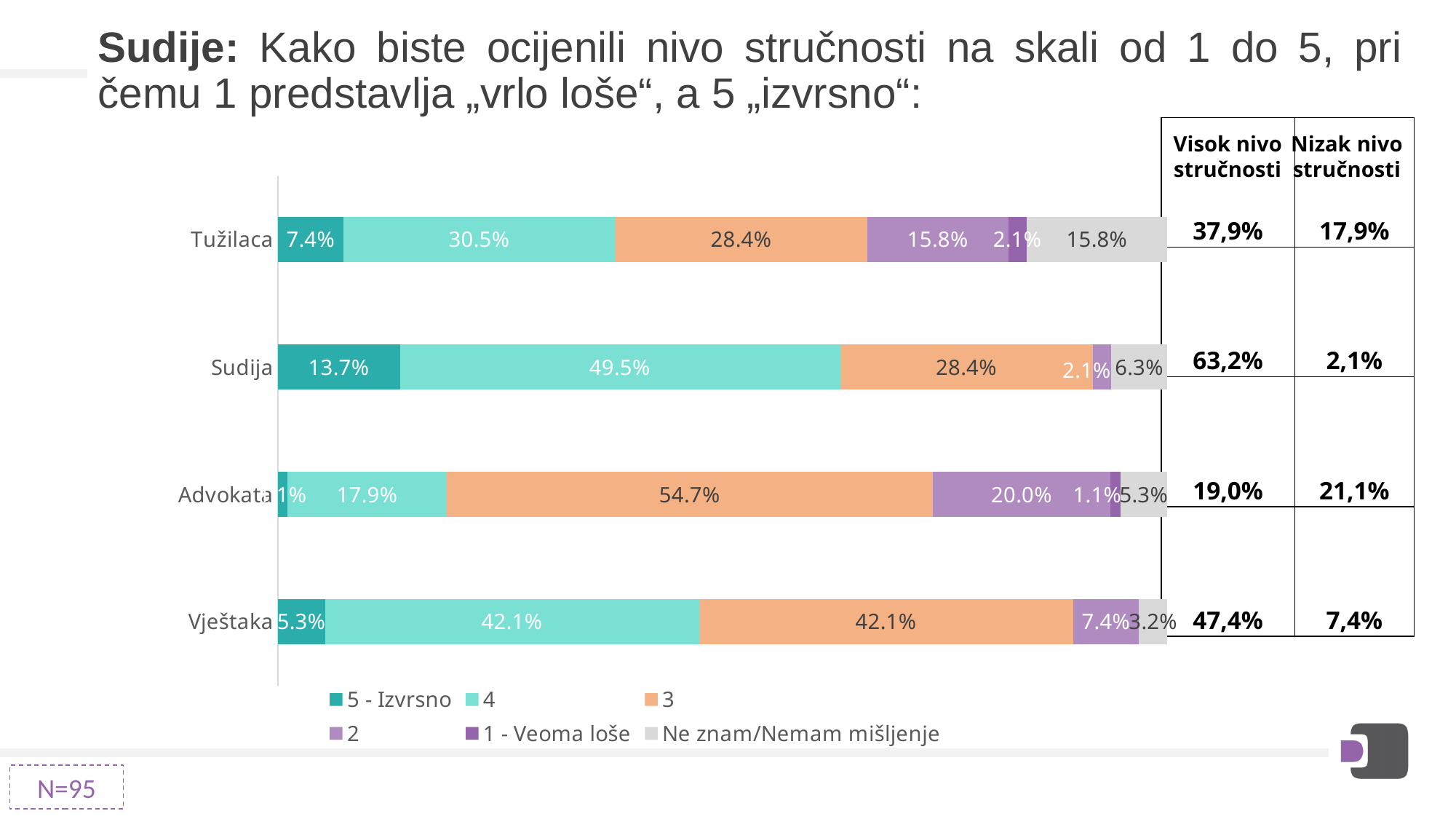
What is the value of the '5 - Izvrsno' series for Tužilaca? 7.4% How many series does the legend list? 6 Which category has the highest value for the '5 - Izvrsno' series? Sudija What is the value of the 'Ne znam/Nemam mišljenje' series for Vještaka? 3.2% How many categories are plotted on the chart? 4 What is the difference between the '2' series values for Advokata and Tužilaca? 4.2% Which is larger: the '3' series value for Vještaka or for Tužilaca? Vještaka What is the value of the '4' series for Sudija? 49.5% What is the value of the '3' series for Advokata? 54.7% Which category has the lowest value for the '4' series? Advokata What kind of chart is shown on the slide? stacked bar chart According to the table next to the chart, what is the 'Visok nivo stručnosti' value for Sudija? 63,2%